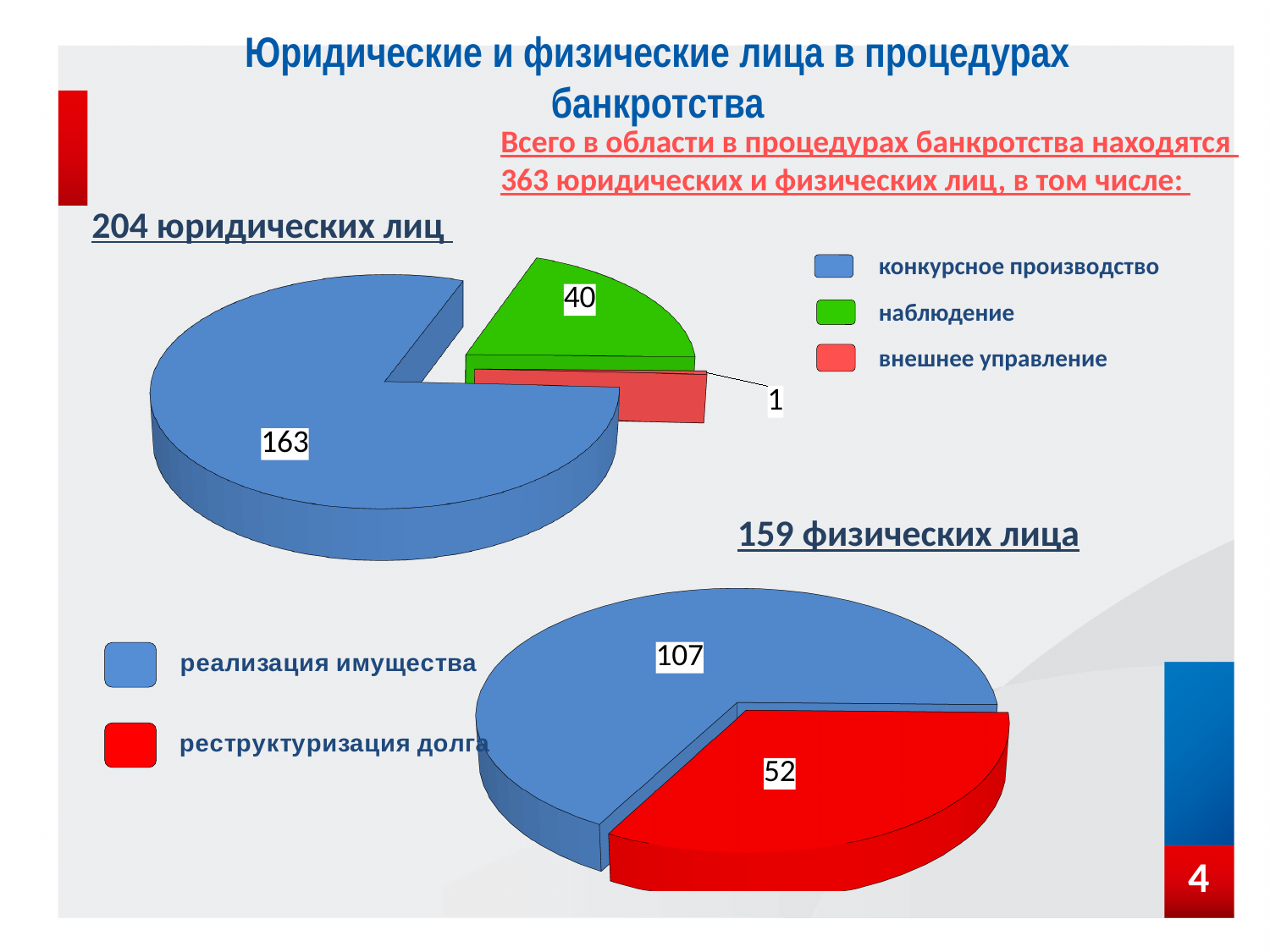
In the chart titled "204 юридических лиц", what is the value for наблюдение? 40 In the chart titled "159 физических лица", what is the difference between реализация имущества and реструктуризация долга? 55 In the chart titled "159 физических лица", which is larger: реализация имущества or реструктуризация долга? реализация имущества In the chart titled "159 физических лица", what is the value for реструктуризация долга? 52 In the chart titled "204 юридических лиц", how many categories does the legend list? 3 In the chart titled "204 юридических лиц", what is the value for конкурсное производство? 163 In the chart titled "159 физических лица", what is the value for реализация имущества? 107 In the chart titled "204 юридических лиц", which category has the largest slice? конкурсное производство In the chart titled "204 юридических лиц", which category has the smallest slice? внешнее управление What kind of chart is the chart titled "159 физических лица"? pie chart In the chart titled "204 юридических лиц", what is the difference between конкурсное производство and наблюдение? 123 In the chart titled "204 юридических лиц", what is the value for внешнее управление? 1